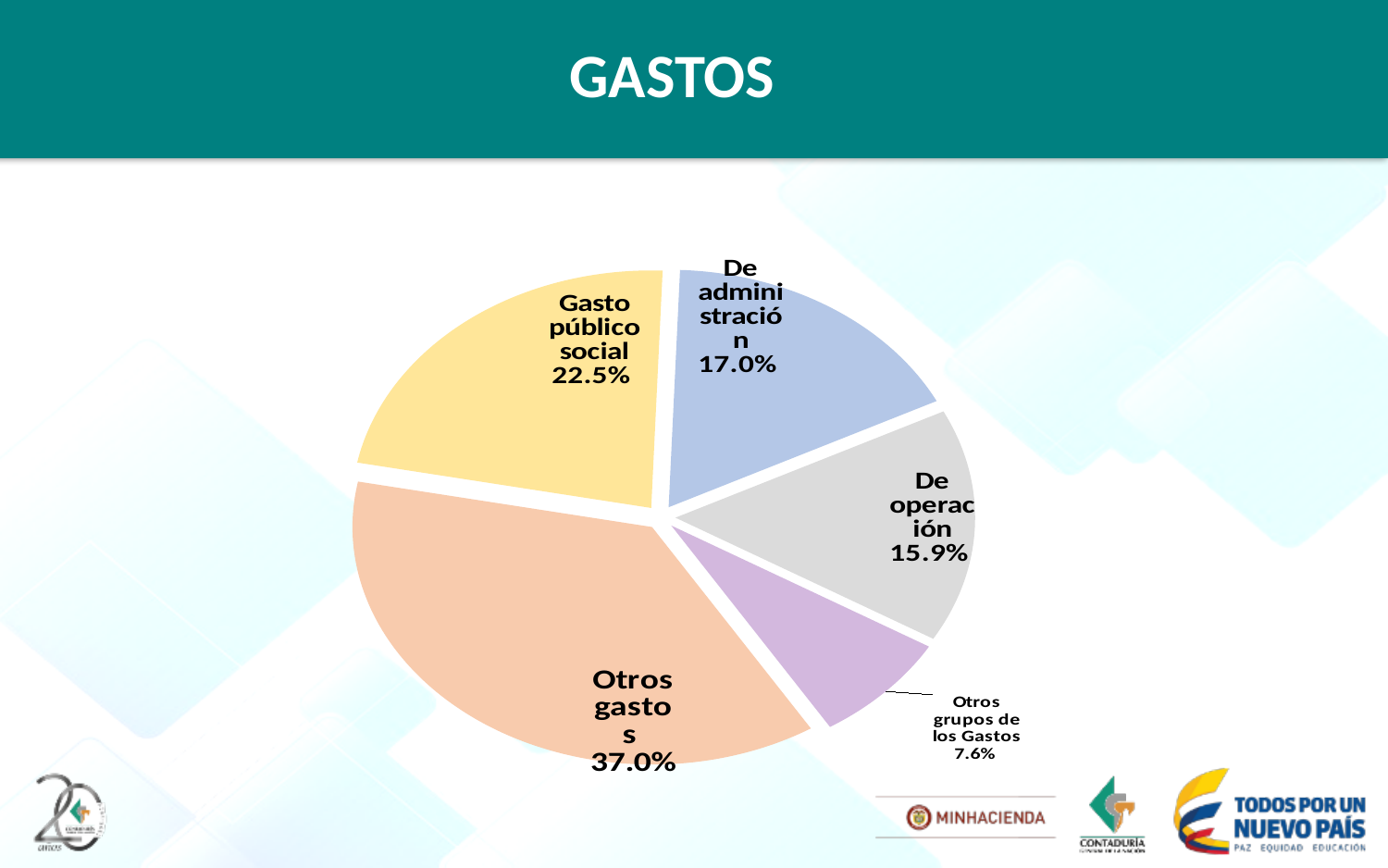
What share of the pie is Otros gastos? 37.0% What share of the pie is De administración? 17.0% Which slice of the pie is the smallest? Otros grupos de los Gastos Which slice of the pie is the largest? Otros gastos What share of the pie is De operación? 15.9% What is the title of the chart? GASTOS What share of the pie is Otros grupos de los Gastos? 7.6% Which is larger, De administración or De operación? De administración What kind of chart is shown on the slide? pie chart What share of the pie is Gasto público social? 22.5% What is the difference in percentage points between Otros gastos and Gasto público social? 14.5 How many slices does the pie chart have? 5